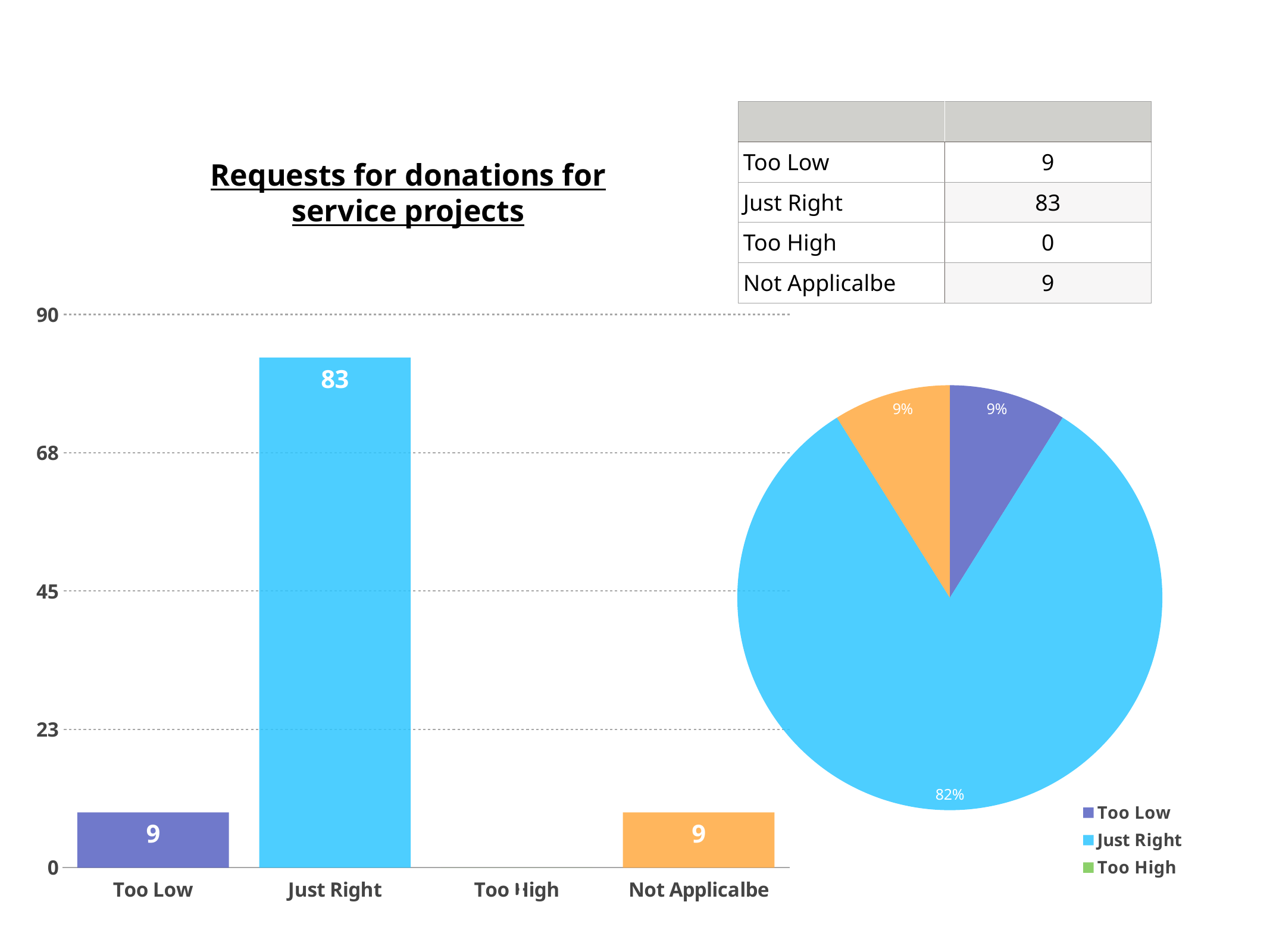
In the bar chart, what is the value for Not Applicalbe? 9 How many categories are shown on the x axis of the bar chart? 4 In the bar chart, what is the difference between the values for Just Right and Too Low? 74 In the bar chart, what is the value for Too Low? 9 What kind of chart is the chart on the left of the slide? bar chart How many entries does the legend of the pie chart list? 3 In the bar chart, which category has the highest value? Just Right In the bar chart, is the value for Just Right greater or less than 68? greater In the bar chart, which category has the lowest value? Too High In the pie chart, what share is shown for the Just Right slice? 82% In the bar chart, what is the value for Just Right? 83 In the bar chart, which is larger, the value for Just Right or the value for Not Applicalbe? Just Right